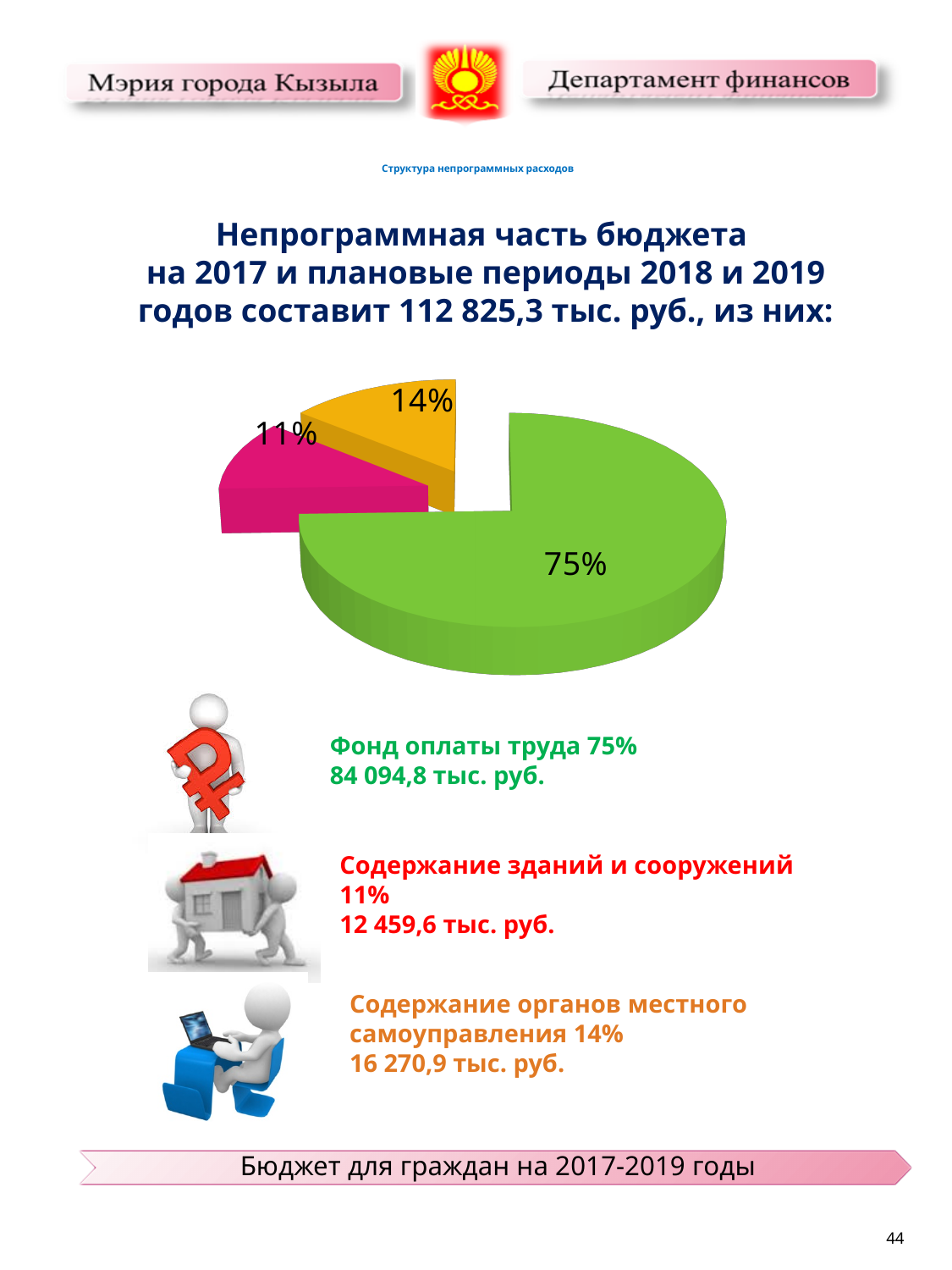
What share of the pie is labelled for Содержание органов местного самоуправления? 14% What amount in тыс. руб. is given for Фонд оплаты труда? 84 094,8 тыс. руб. Which category has the largest share of the pie? Фонд оплаты труда What kind of chart is shown on the slide? Pie chart What share of the pie does the smallest slice represent? 11% How many slices does the pie chart have? 3 What is the total amount of the non-programme part of the budget stated on the slide? 112 825,3 тыс. руб. What is the difference in percentage points between the 75% slice and the 11% slice? 64 percentage points What colour is the 75% slice of the pie chart? Green What share of the pie does the largest slice represent? 75% Which slice is larger: the one for Содержание зданий и сооружений or the one for Содержание органов местного самоуправления? Содержание органов местного самоуправления Which category has the smallest share of the pie? Содержание зданий и сооружений